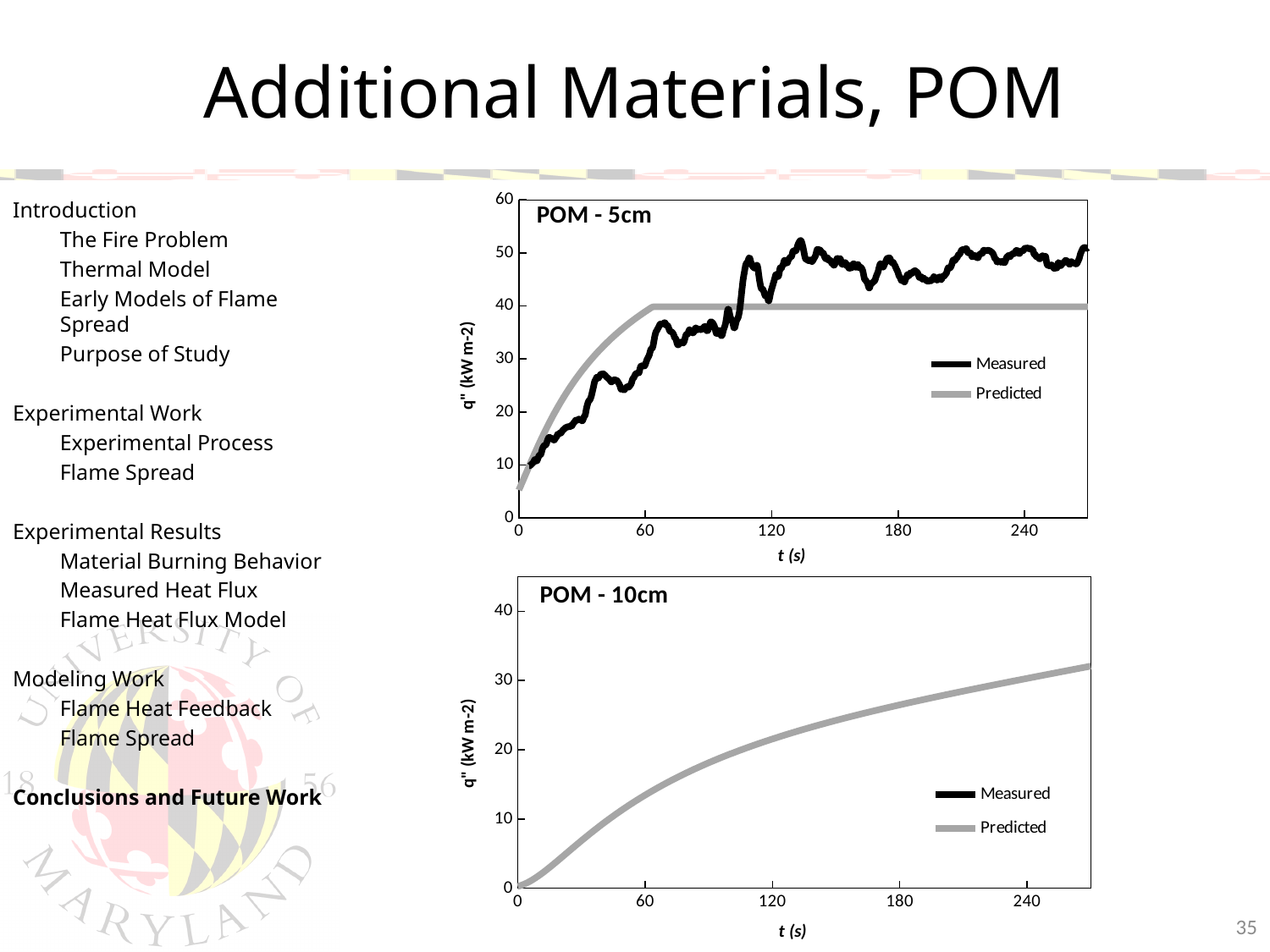
What kind of chart is the 'POM - 5cm' chart? line chart In the 'POM - 5cm' chart, at t = 240 s, which series has the larger value, Measured or Predicted? Measured What are the two legend entries in the 'POM - 10cm' chart? Measured and Predicted In the 'POM - 10cm' chart, is the Predicted value at t = 60 s greater or less than 10? greater What is the x-axis label of the 'POM - 5cm' chart? t (s) In the 'POM - 5cm' chart, at what value does the Predicted line plateau after about 60 s? 40 How many series does the legend of the 'POM - 5cm' chart list? 2 In the 'POM - 5cm' chart, is the Predicted value at t = 180 s greater or less than 30? greater In the 'POM - 10cm' chart, is the Predicted value at t = 240 s greater or less than 20? greater In the 'POM - 10cm' chart, does the Predicted line rise or fall as t increases? rise